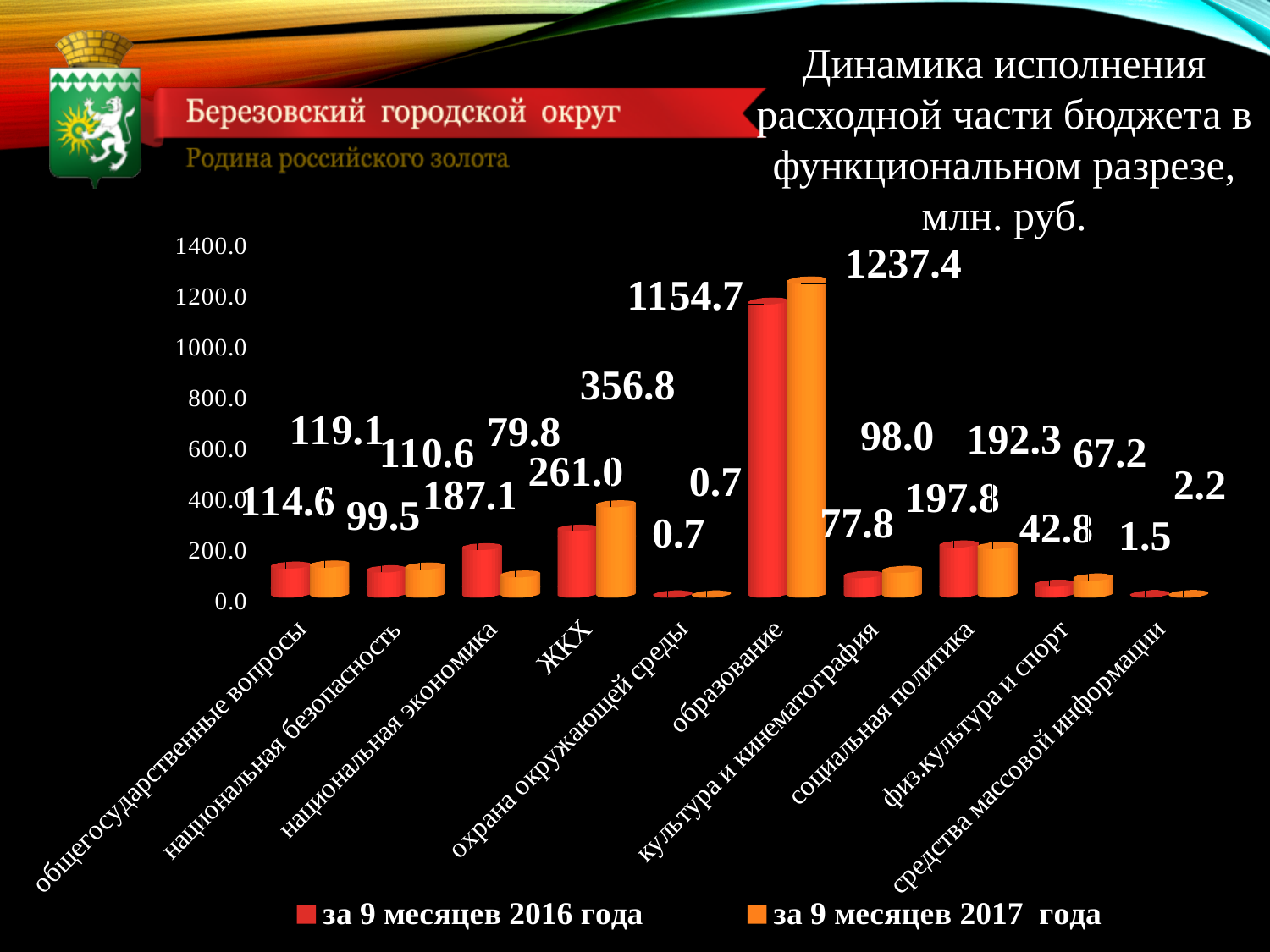
What unit is stated in the chart title? млн. руб. How many categories are shown on the x axis? 10 Which category has the lowest value for за 9 месяцев 2017 года? охрана окружающей среды How many series does the legend list? 2 What is the difference between the 2017 and 2016 values for ЖКХ? 95.8 What is the value for ЖКХ for за 9 месяцев 2016 года? 261.0 Which category has the highest value for за 9 месяцев 2016 года? образование Which is larger for национальная экономика: the value for за 9 месяцев 2016 года or за 9 месяцев 2017 года? за 9 месяцев 2016 года What is the value for образование for за 9 месяцев 2017 года? 1237.4 What type of chart is shown on the slide? bar chart Is the value for образование for за 9 месяцев 2016 года greater or less than 1000.0? greater What is the value for национальная экономика for за 9 месяцев 2017 года? 79.8